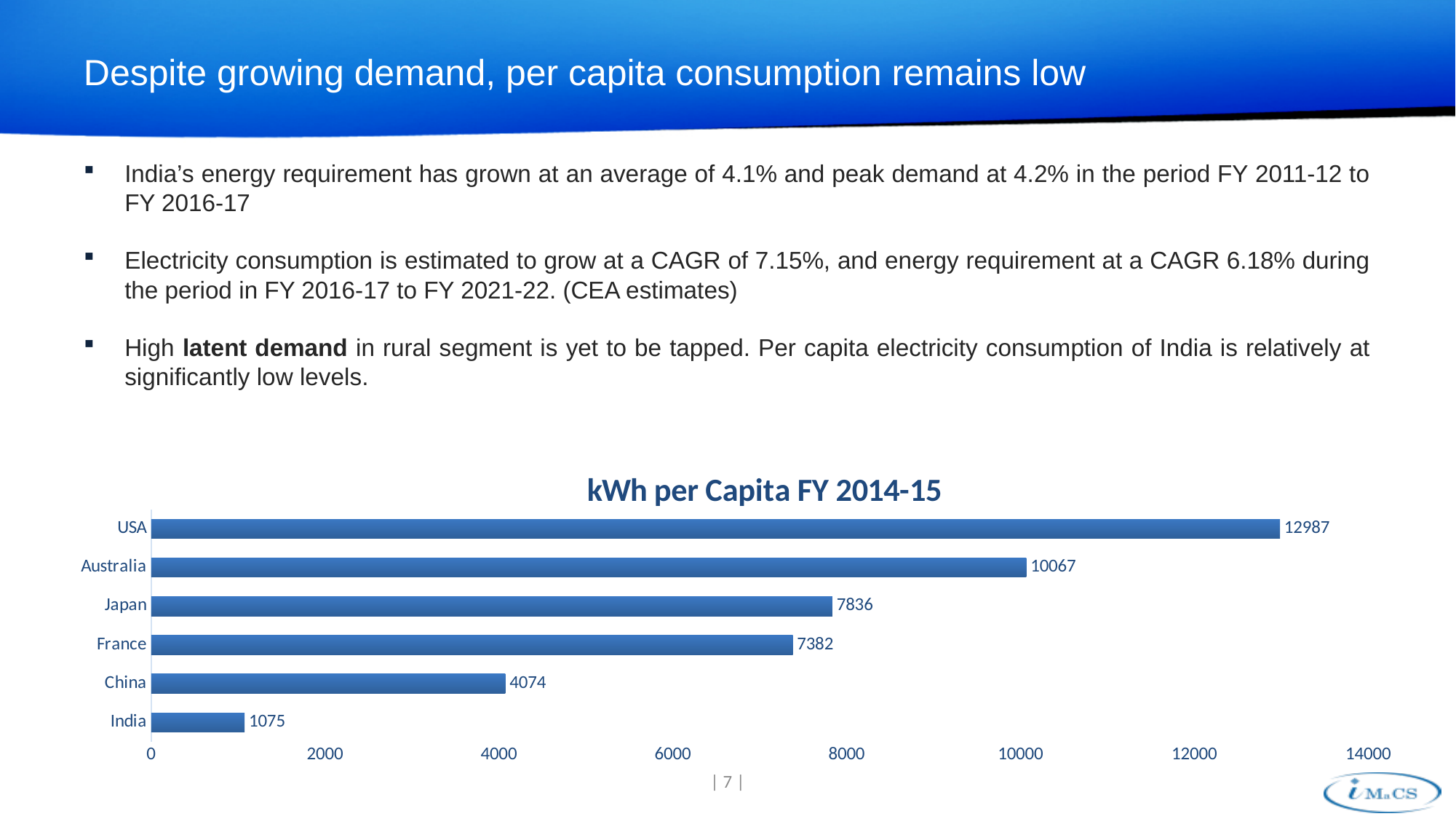
How many countries are shown in the chart? 6 Which country has the lowest kWh per capita? India What is the difference in kWh per capita between USA and India? 11912 What is the kWh per capita value for USA? 12987 Which country has the highest kWh per capita? USA Is the value for China greater or less than 6000? less What is the kWh per capita value for India? 1075 What is the kWh per capita value for Japan? 7836 Which has a higher kWh per capita, Australia or France? Australia What type of chart is shown on the slide? Bar chart What is the kWh per capita value for China? 4074 What is the difference in kWh per capita between Japan and France? 454